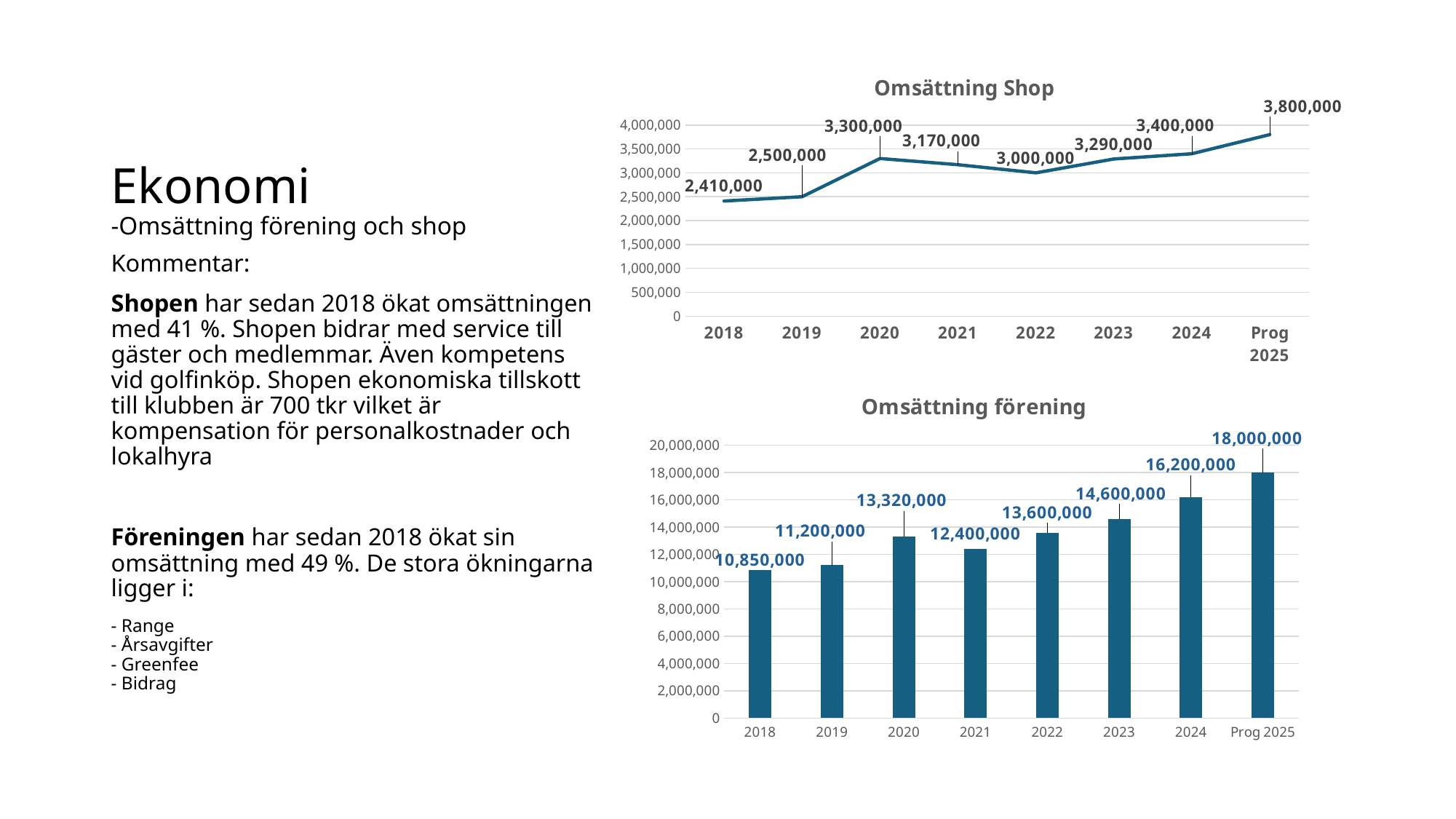
In the "Omsättning förening" chart, what is the difference between the values for 2024 and 2023? 1,600,000 How many bars are in the "Omsättning förening" chart? 8 What kind of chart is "Omsättning förening"? Bar chart In the "Omsättning Shop" chart, which is larger, the value for 2020 or the value for 2021? 2020 In the "Omsättning Shop" chart, what is the value for 2022? 3,000,000 In the "Omsättning förening" chart, what is the value for 2020? 13,320,000 What kind of chart is "Omsättning Shop"? Line chart In the "Omsättning förening" chart, which year has the highest value? Prog 2025 In the "Omsättning Shop" chart, what is the value for 2018? 2,410,000 In the "Omsättning Shop" chart, which year has the lowest value? 2018 In the "Omsättning Shop" chart, what is the difference between the values for Prog 2025 and 2024? 400,000 In the "Omsättning förening" chart, do the values generally rise or fall from 2018 to Prog 2025? Rise